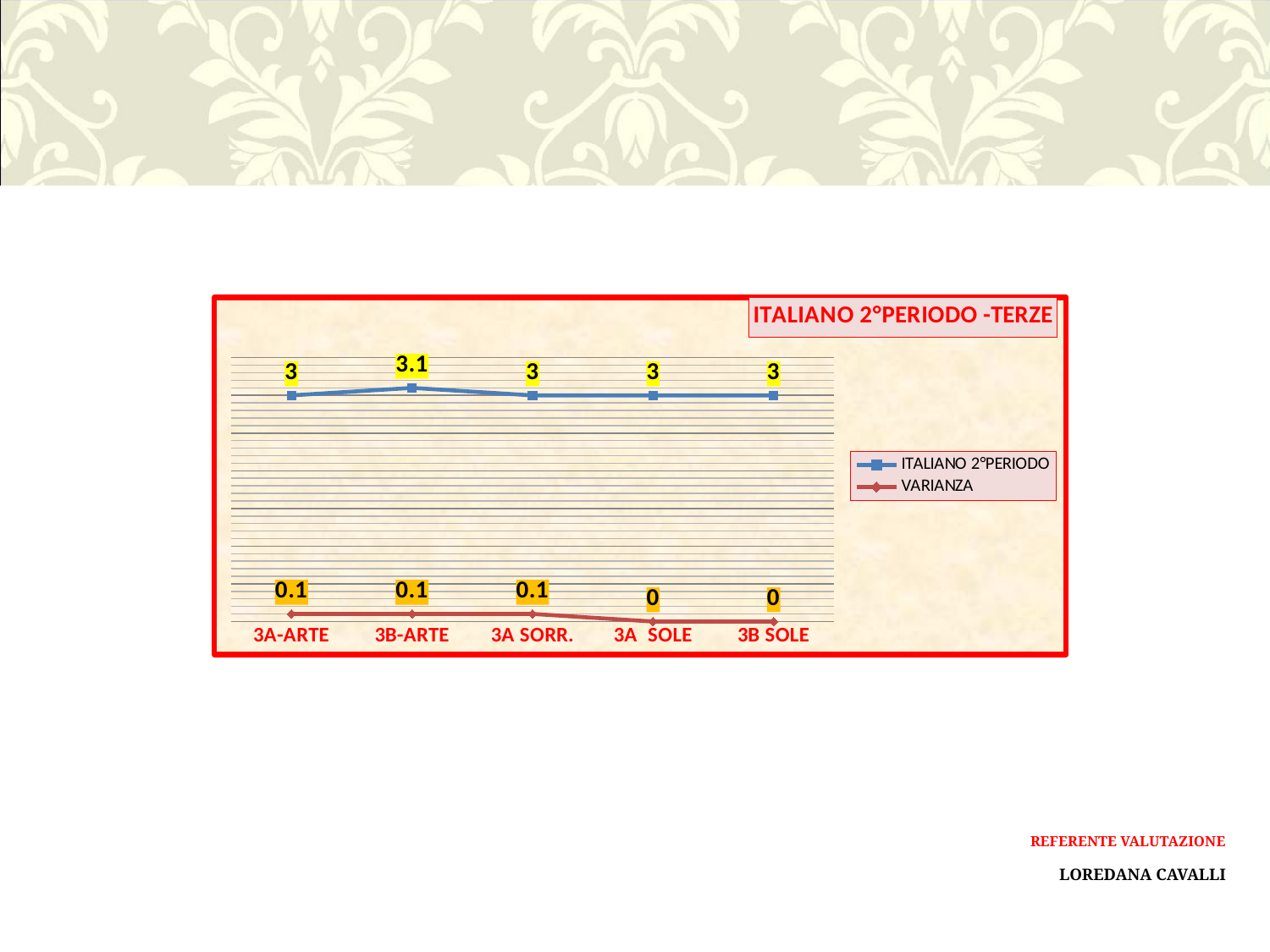
What is the ITALIANO 2°PERIODO value for 3B-ARTE? 3.1 What is the VARIANZA value for 3A-ARTE? 0.1 What is the ITALIANO 2°PERIODO value for 3A SORR.? 3 What type of chart is shown on the slide? line chart What is the VARIANZA value for 3B SOLE? 0 Which is larger, the VARIANZA value for 3A SORR. or for 3A SOLE? 3A SORR. What is the title of the chart? ITALIANO 2°PERIODO -TERZE How many series does the legend list? 2 How many categories are shown on the x axis? 5 Does the VARIANZA series rise or fall from 3A SORR. to 3A SOLE? fall What is the difference between the ITALIANO 2°PERIODO values for 3B-ARTE and 3A-ARTE? 0.1 Which category has the highest ITALIANO 2°PERIODO value? 3B-ARTE